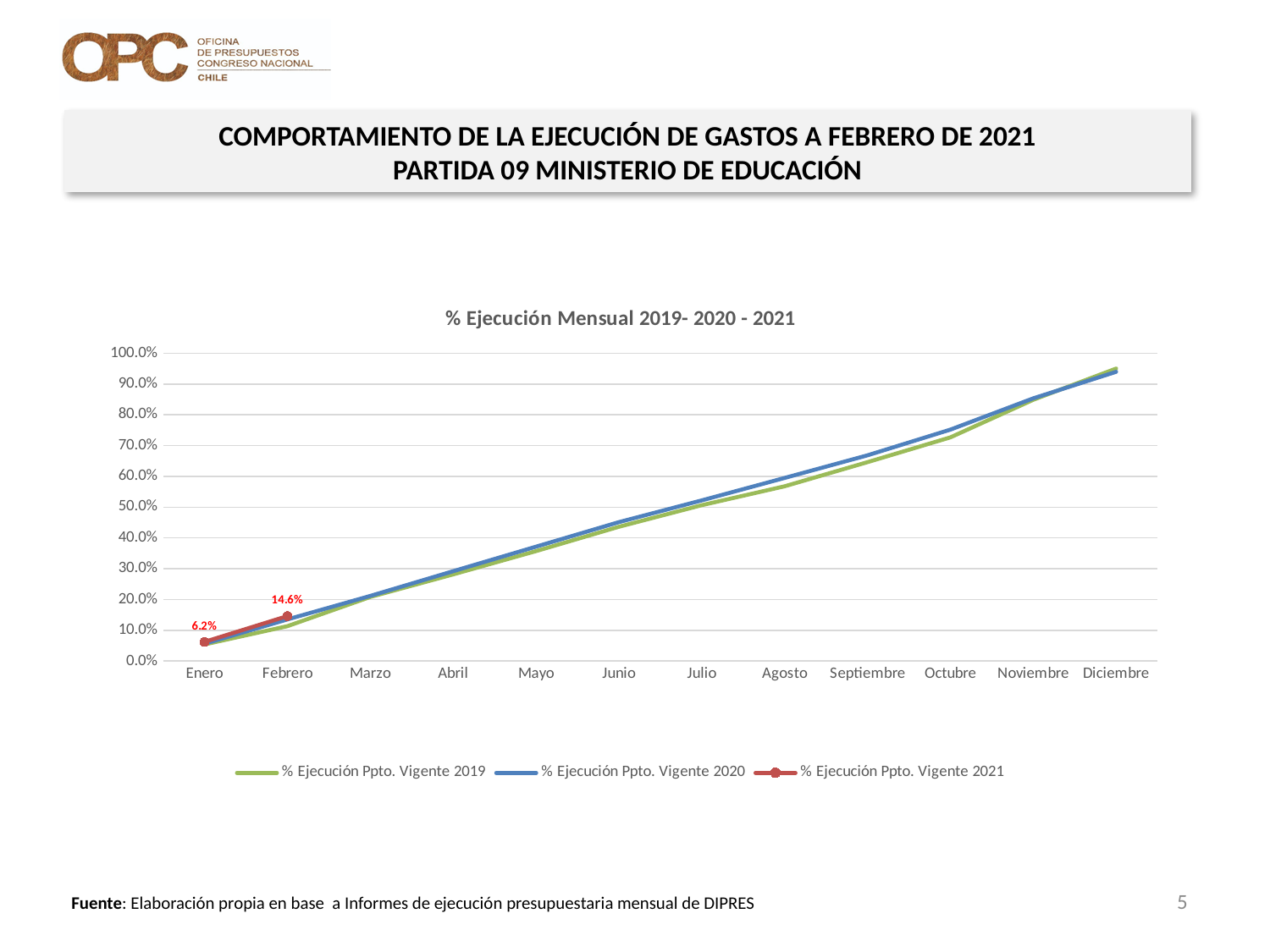
How many series does the chart's legend list? 3 Is the value for Octubre in the % Ejecución Ppto. Vigente 2019 series greater or less than 80.0%? less Do the values of the % Ejecución Ppto. Vigente 2020 series rise or fall from Enero to Diciembre? Rise Which series in the legend is drawn in red with markers? % Ejecución Ppto. Vigente 2021 Which month has the higher value in the % Ejecución Ppto. Vigente 2021 series, Enero or Febrero? Febrero How many months are shown on the x axis of the chart? 12 What is the value for Febrero in the % Ejecución Ppto. Vigente 2021 series? 14.6% What kind of chart is shown on the slide? Line chart Is the value for Diciembre in the % Ejecución Ppto. Vigente 2020 series greater or less than 90.0%? greater What is the title of the chart? % Ejecución Mensual 2019- 2020 - 2021 By how many percentage points did the % Ejecución Ppto. Vigente 2021 series increase from Enero to Febrero? 8.4 percentage points What is the value for Enero in the % Ejecución Ppto. Vigente 2021 series? 6.2%